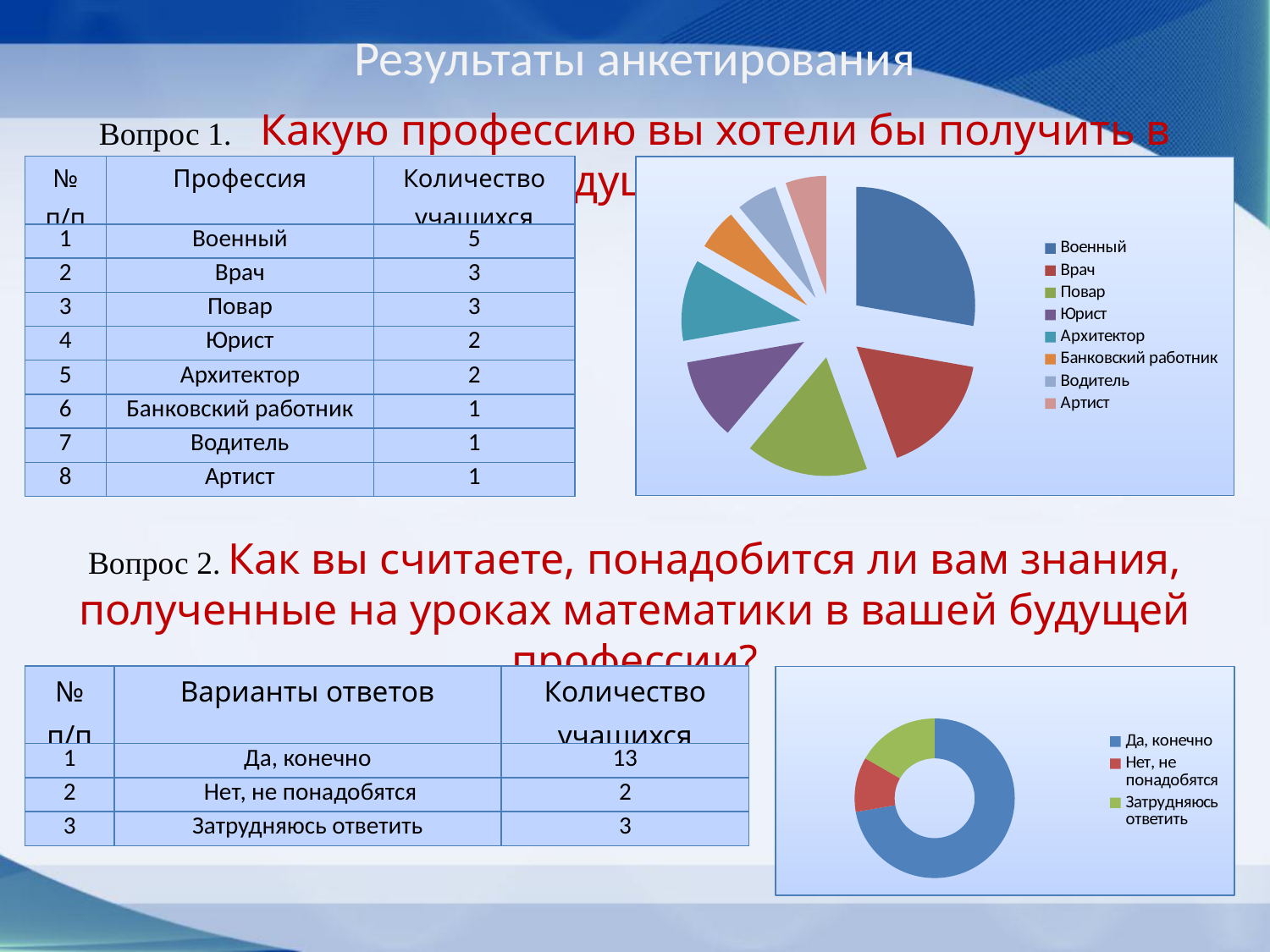
In the bottom doughnut chart, which is larger: Затрудняюсь ответить or Нет, не понадобятся? Затрудняюсь ответить According to the Вопрос 2 table, how many students answered Да, конечно? 13 What kind of chart is the bottom chart next to the Вопрос 2 table? doughnut chart In the bottom doughnut chart, which answer has the smallest share? Нет, не понадобятся In the top pie chart, which profession has the largest slice? Военный What kind of chart is the top chart next to the Вопрос 1 table? pie chart In the top pie chart, which slice is larger: Военный or Юрист? Военный According to the Вопрос 1 table, how many students chose Военный? 5 In the top pie chart, how many categories does the legend list? 8 In the bottom doughnut chart, how many categories does the legend list? 3 In the top pie chart, what colour is the Военный slice? blue In the bottom doughnut chart, which answer has the largest share? Да, конечно